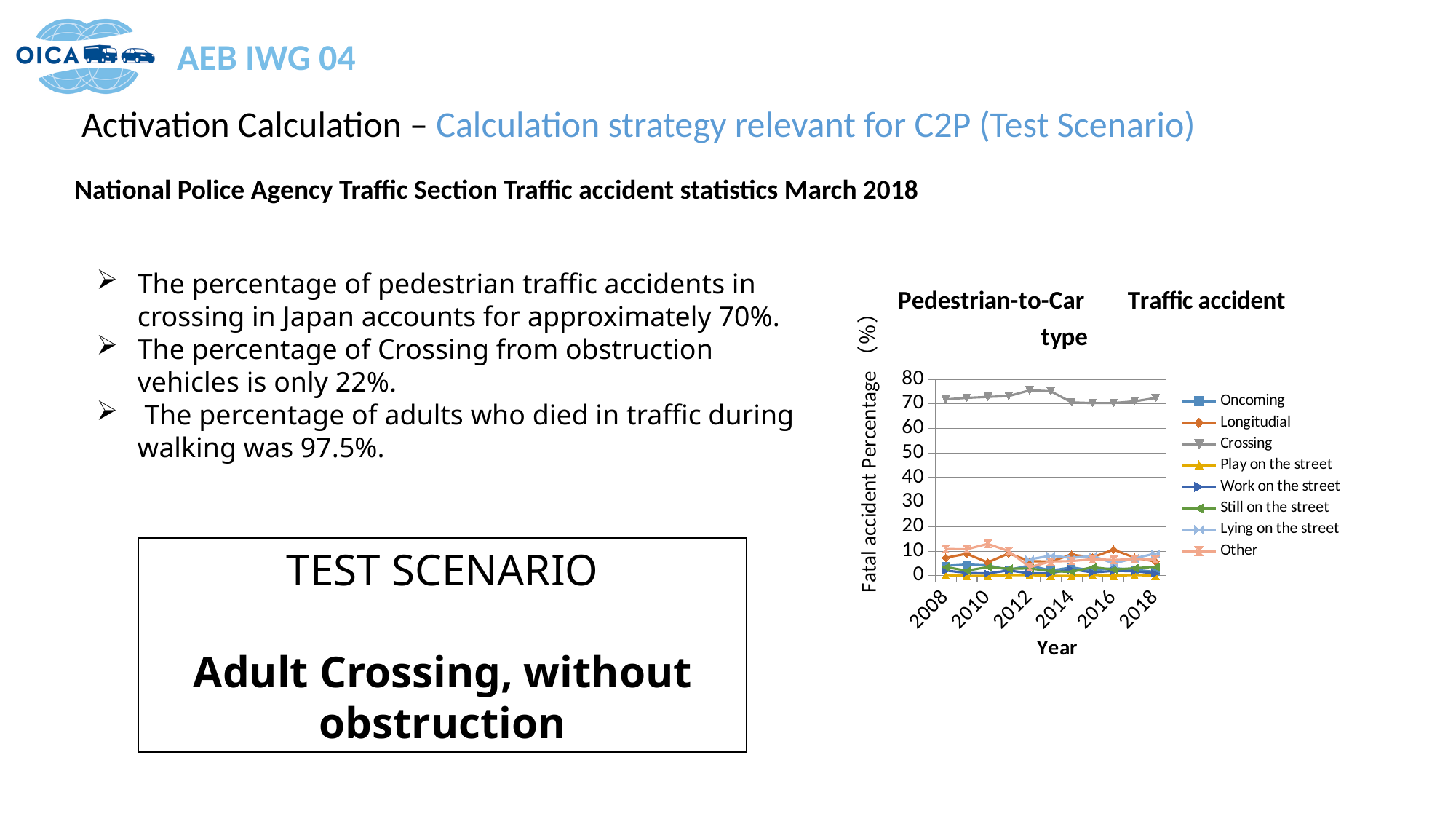
What is the title of the chart? Pedestrian-to-Car Traffic accident type Which series has the highest values across all years in the chart? Crossing What kind of chart is shown on the slide? line chart In 2014, which is larger, the value for Crossing or the value for Longitudial? Crossing Is the value for Crossing in 2016 greater or less than 60? greater What is the label of the chart's y axis? Fatal accident Percentage (%) Between 2013 and 2014, does the Crossing line rise or fall? fall Is the value for Oncoming in 2010 greater or less than 20? less How many series does the chart's legend list? 8 Is the value for Other in 2010 greater or less than 10? greater How many year labels are shown on the x axis of the chart? 6